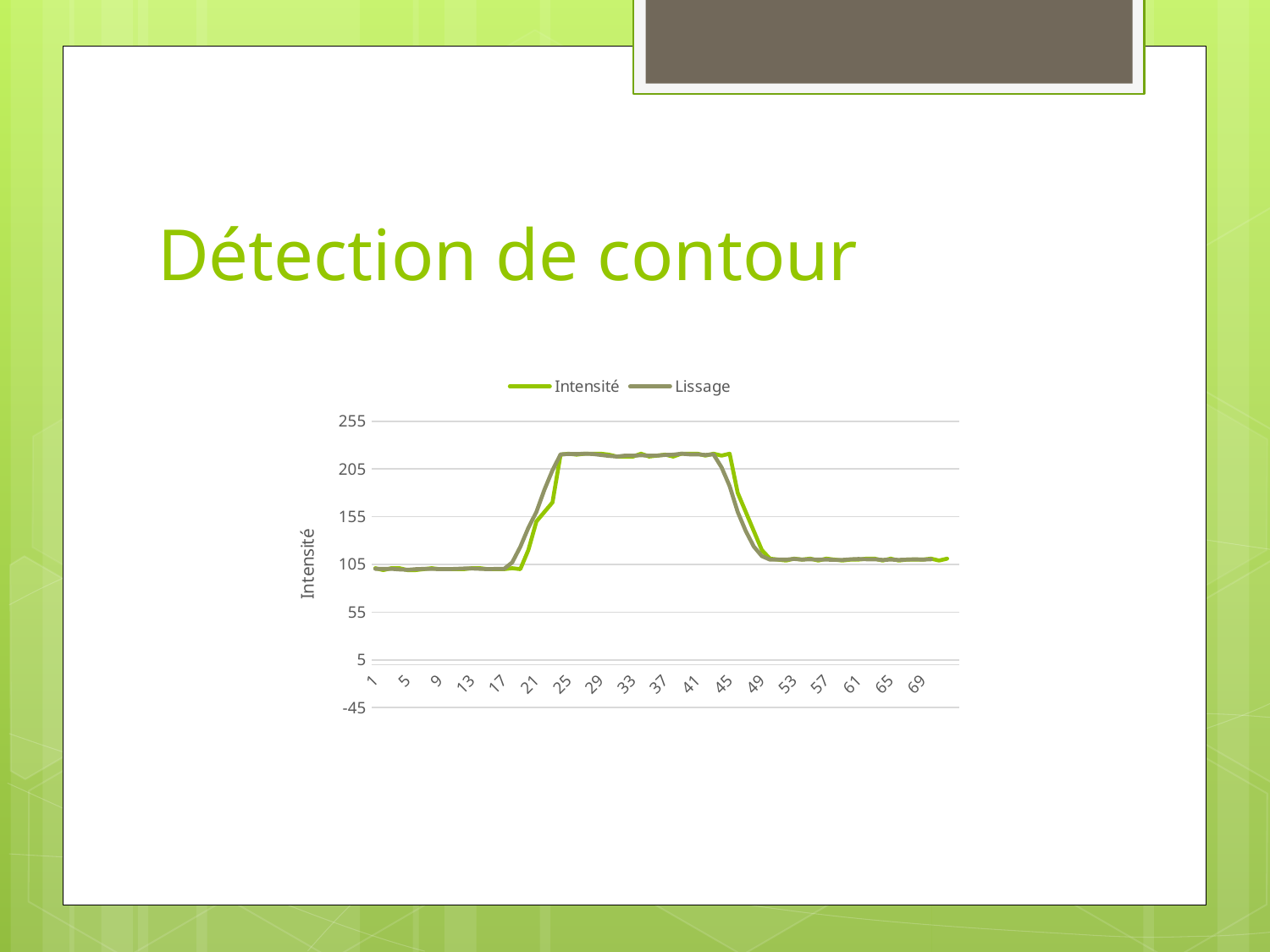
What is the highest value shown on the vertical axis? 255 What is the last label shown on the horizontal axis? 69 Is the value of Intensité at x = 33 greater or less than 205? greater Between x = 17 and x = 25, does the Intensité line rise or fall? rise Is the value of Intensité at x = 9 greater or less than 155? less Is the value of Lissage at x = 61 greater or less than 155? less What is the lowest value shown on the vertical axis? -45 How many series does the legend list? 2 What is the title of the vertical axis? Intensité What kind of chart is shown on the slide? line chart What are the two series named in the legend? Intensité and Lissage Between x = 45 and x = 49, does the Lissage line rise or fall? fall